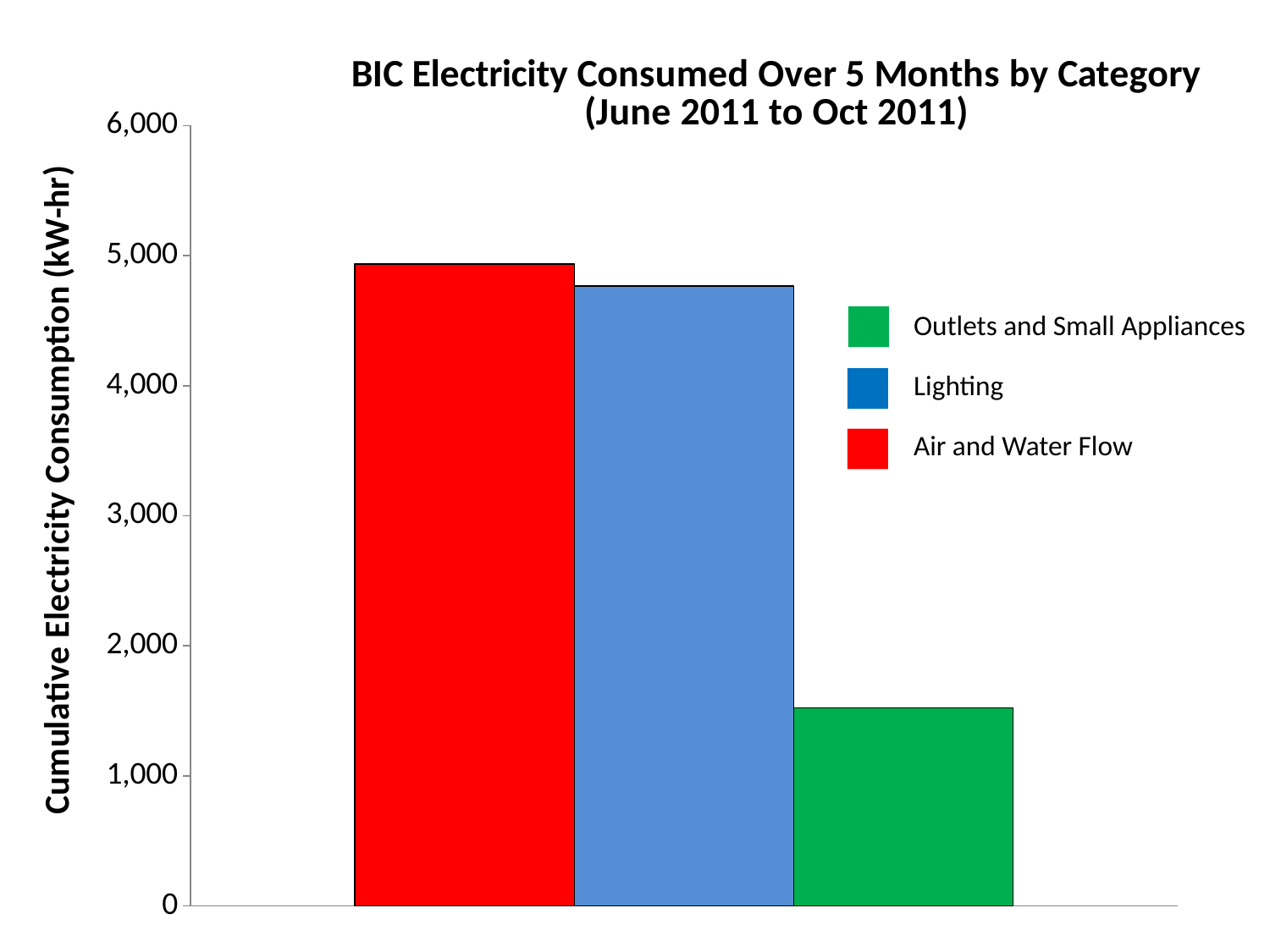
Which category has the highest cumulative electricity consumption? Air and Water Flow What colour is the bar for Lighting? Blue What is the label on the vertical axis of the chart? Cumulative Electricity Consumption (kW-hr) Is the value for Outlets and Small Appliances greater or less than 2,000? less Which is larger, the value for Lighting or the value for Outlets and Small Appliances? Lighting What kind of chart is shown on the slide? Bar chart Is the value for Lighting greater or less than 4,000? greater How many series does the legend list? 3 Which category has the lowest cumulative electricity consumption? Outlets and Small Appliances How many bars are plotted in the chart? 3 Is the value for Air and Water Flow greater or less than 5,000? less